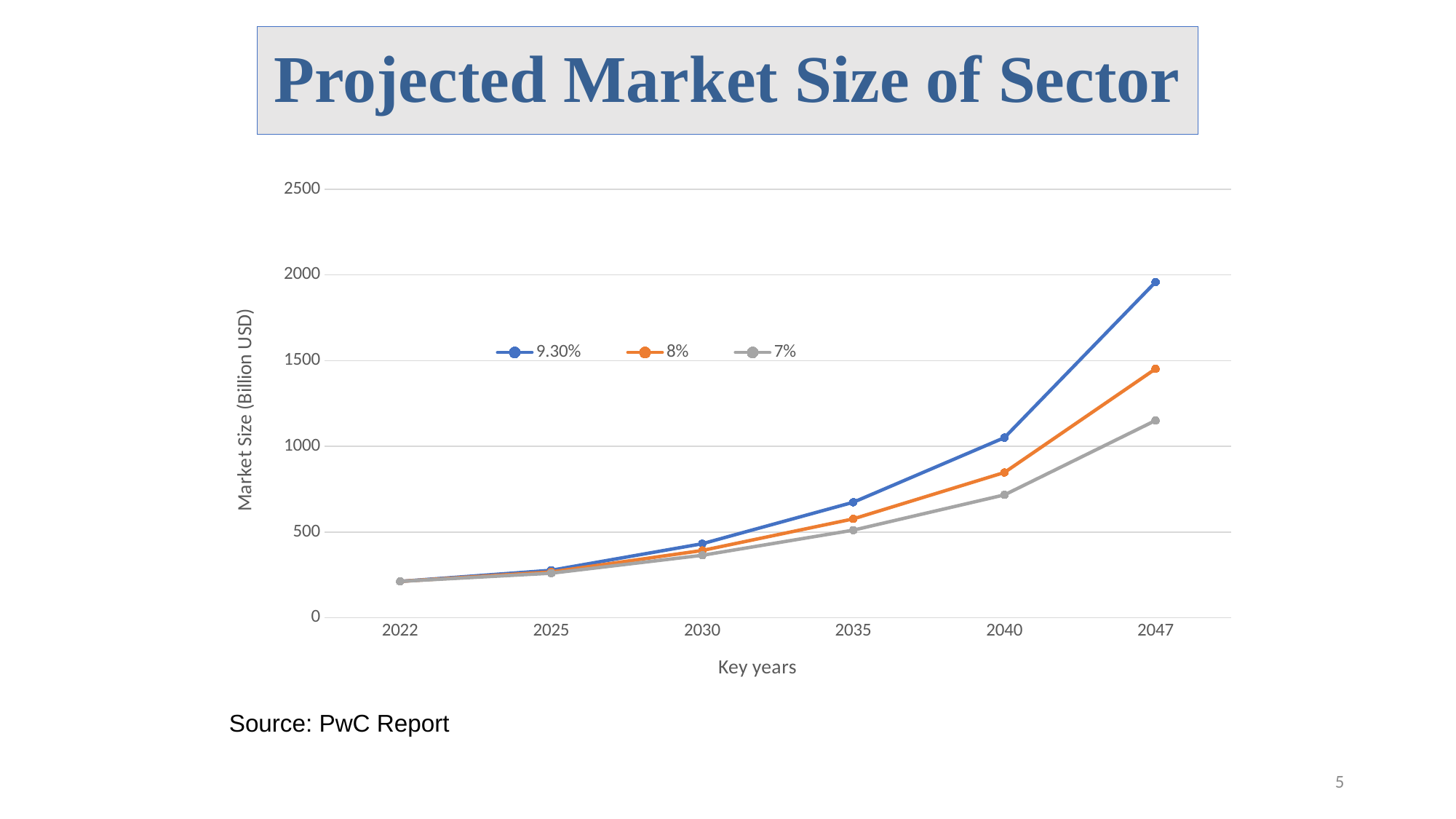
Which series has the lowest value in 2047? 7% How many years are plotted along the x axis? 6 In 2040, which is larger: the value for the 9.30% series or the 7% series? 9.30% Is the value for the 8% series in 2047 greater or less than 1500? less What is the label of the y axis? Market Size (Billion USD) Do the values of the 9.30% series rise or fall from 2022 to 2047? rise Is the value for the 9.30% series in 2047 greater or less than 1500? greater Which series has the highest value in 2047? 9.30% How many series does the legend list? 3 Is the value for the 9.30% series in 2030 greater or less than 500? less What kind of chart is shown on the slide? line chart